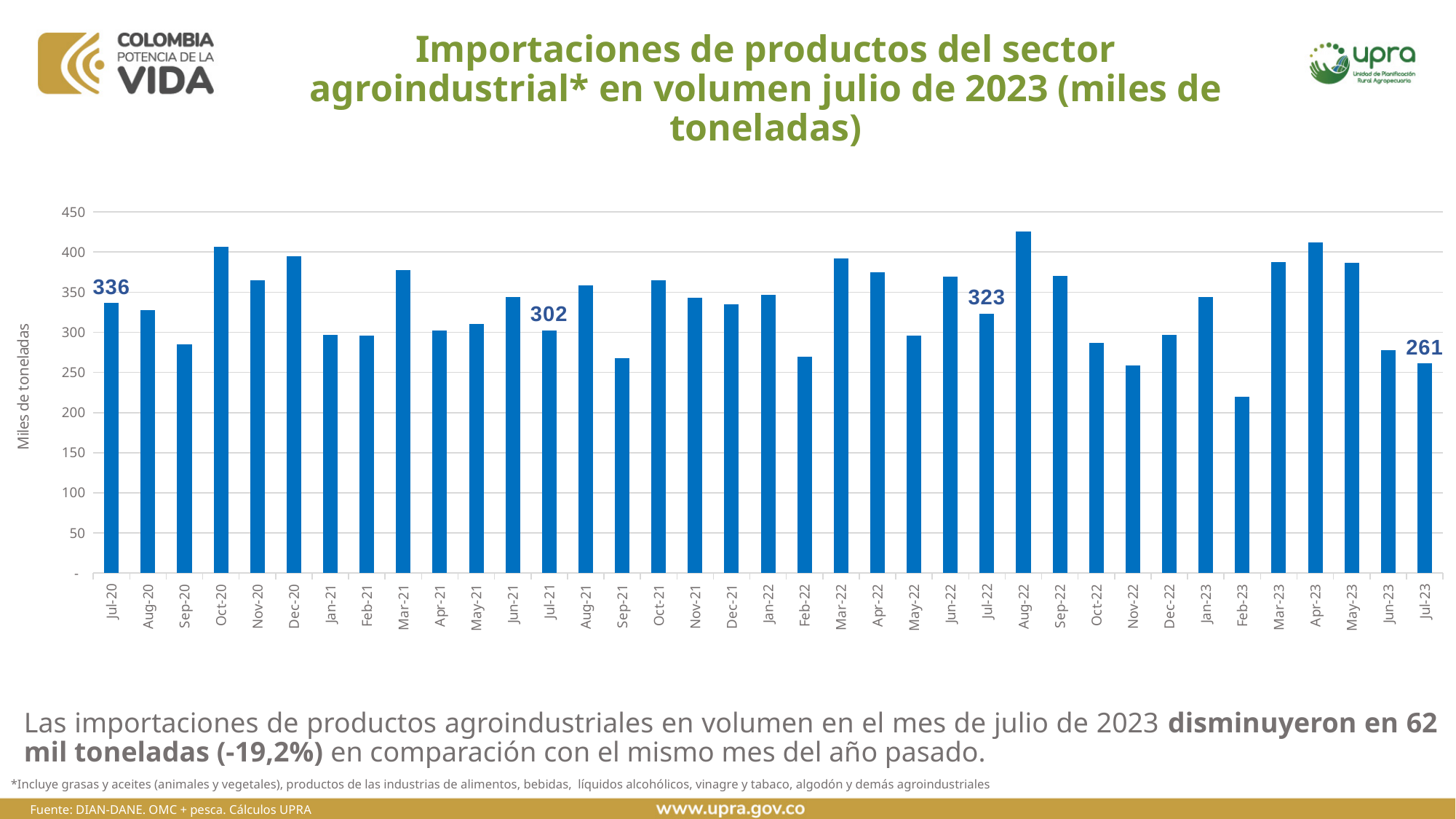
What is the difference between the values for Jul-22 and Jul-23? 62 Which is larger, the value for Jul-20 or the value for Jul-21? Jul-20 What kind of chart is shown on the slide? bar chart Which month has the lowest bar? Feb-23 What is the value for Jul-21? 302 What is the difference between the values for Jul-20 and Jul-23? 75 What is the value for Jul-23? 261 What is the value for Jul-20? 336 Is the value for Oct-20 greater or less than 400? greater What is the value for Jul-22? 323 Which month has the highest bar? Aug-22 Is the value for Feb-23 greater or less than 250? less